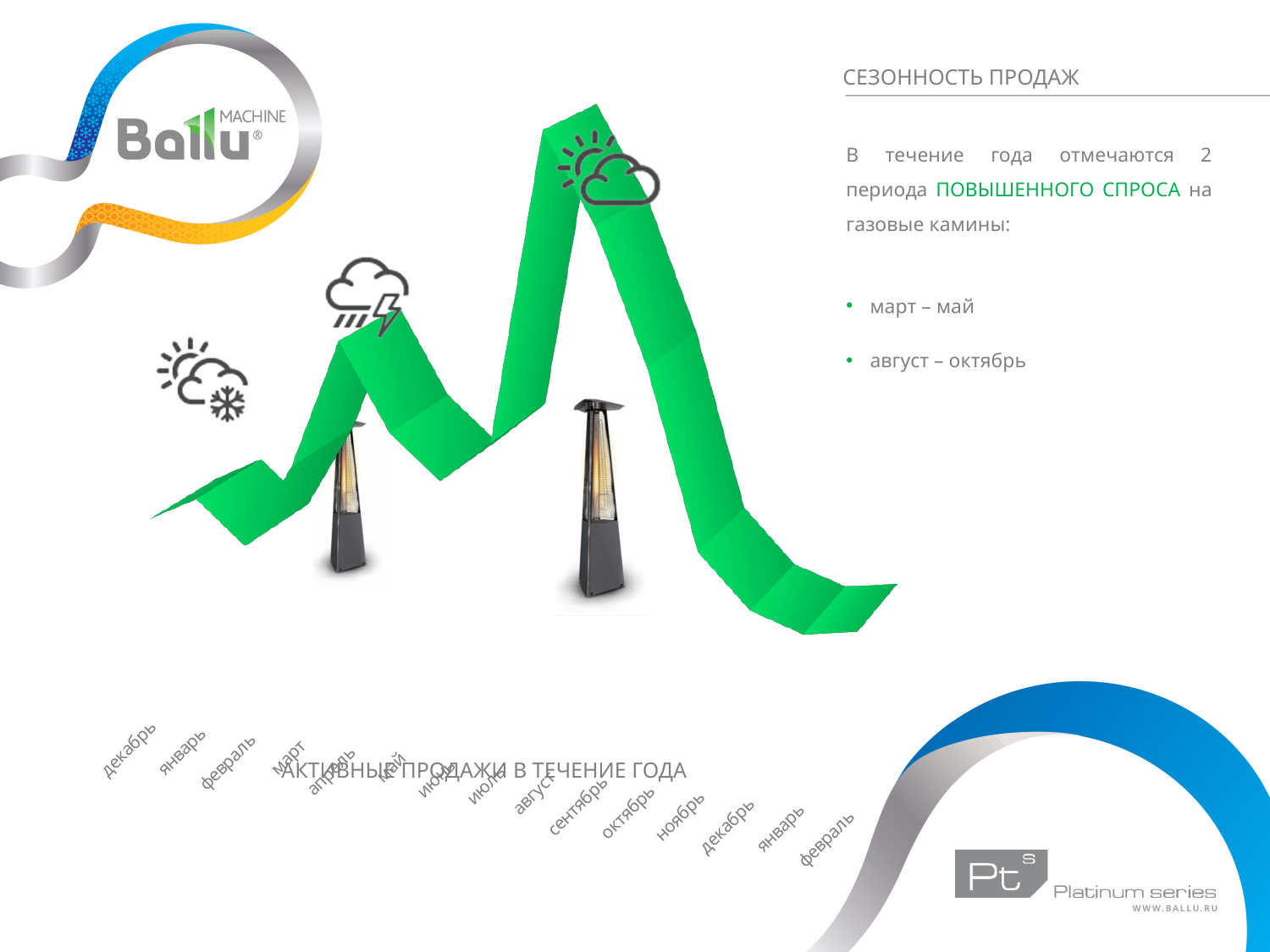
How many month labels are shown along the x axis of the chart? 15 Does the line rise or fall between февраль and the first (spring) peak? rise What is the title of the chart? АКТИВНЫЕ ПРОДАЖИ В ТЕЧЕНИЕ ГОДА Is the autumn peak of the line higher or lower than the spring peak? higher Does the line rise or fall between the autumn peak and the end of the series on the right? fall What kind of chart is shown on the slide? line chart How many peaks does the line in the chart have? 2 Is the end point of the line on the right higher or lower than its starting point on the left? lower What colour is the line in the chart? green